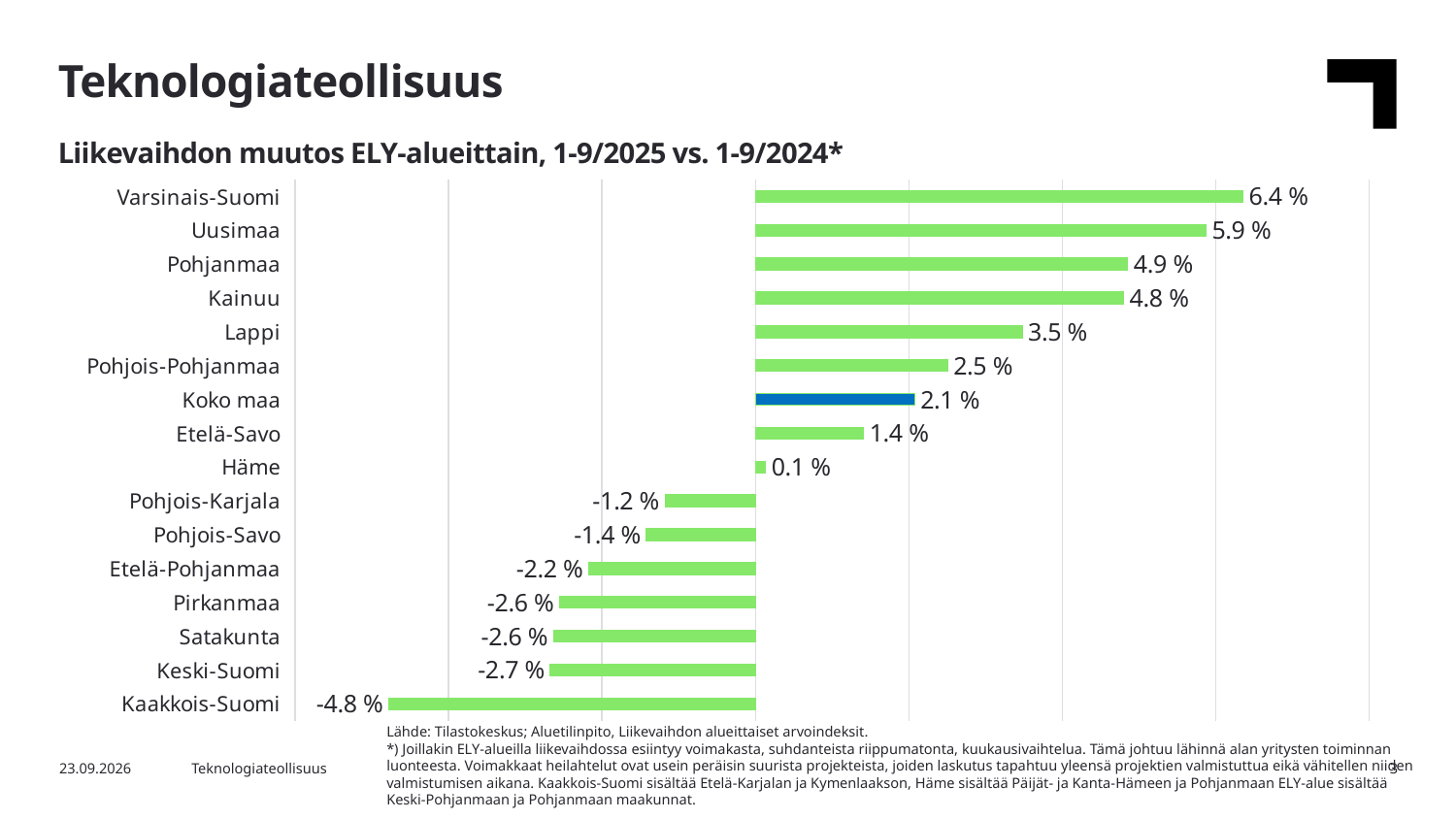
What is the value for Kaakkois-Suomi? -4.8 % How many categories are shown in the chart? 16 What is the difference between the values for Uusimaa and Lappi? 2.4 % Which has a larger value, Pohjanmaa or Pohjois-Pohjanmaa? Pohjanmaa What kind of chart is shown on the slide? Bar chart What is the value for Koko maa? 2.1 % Which ELY area has the lowest value? Kaakkois-Suomi What is the value for Häme? 0.1 % Which bar is coloured blue instead of green? Koko maa What is the value for Varsinais-Suomi? 6.4 % What is the title of the chart? Liikevaihdon muutos ELY-alueittain, 1-9/2025 vs. 1-9/2024* Which ELY area has the highest value? Varsinais-Suomi